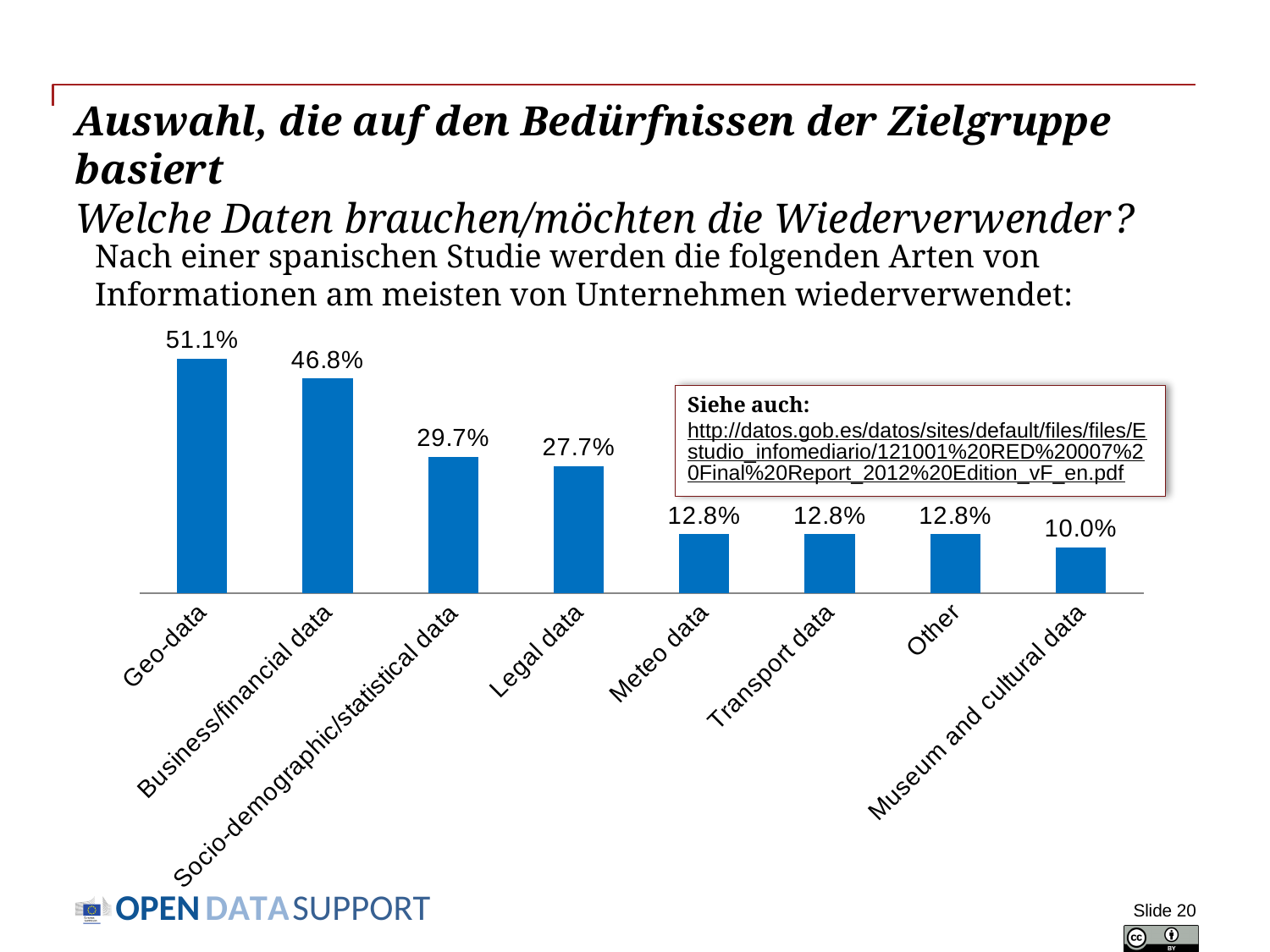
What is the value for Business/financial data? 46.8% Which is larger, the value for Socio-demographic/statistical data or the value for Legal data? Socio-demographic/statistical data What is the value for Museum and cultural data? 10.0% What is the difference between the values for Geo-data and Business/financial data? 4.3% What is the value for Legal data? 27.7% Which category has the highest value? Geo-data How many categories share the value 12.8%? 3 What kind of chart is shown on the slide? Bar chart What is the difference between the values for Socio-demographic/statistical data and Legal data? 2.0% Which category has the lowest value? Museum and cultural data What is the value for Geo-data? 51.1% How many categories are shown in the chart? 8